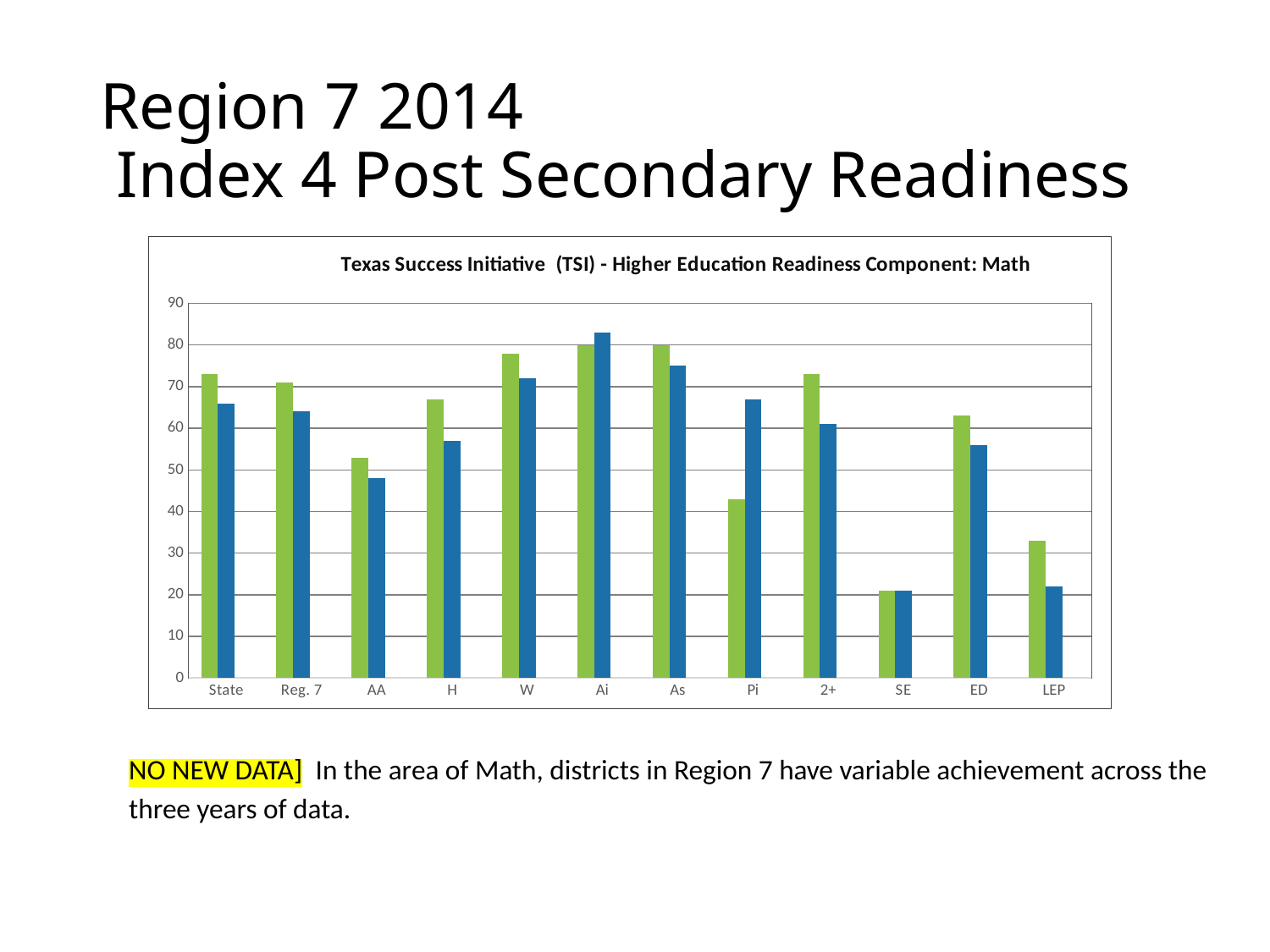
Is the green bar for H greater or less than 70? less For the Pi category, which bar is taller, the green one or the blue one? blue Which category has the lowest green bar? SE Is the green bar for LEP greater or less than 30? greater Is the blue bar for AA greater or less than 50? less What kind of chart is shown on the slide? bar chart For the State category, which bar is taller, the green one or the blue one? green What is the title of the chart? Texas Success Initiative (TSI) - Higher Education Readiness Component: Math Which category has the highest blue bar? Ai How many categories are shown along the x axis of the chart? 12